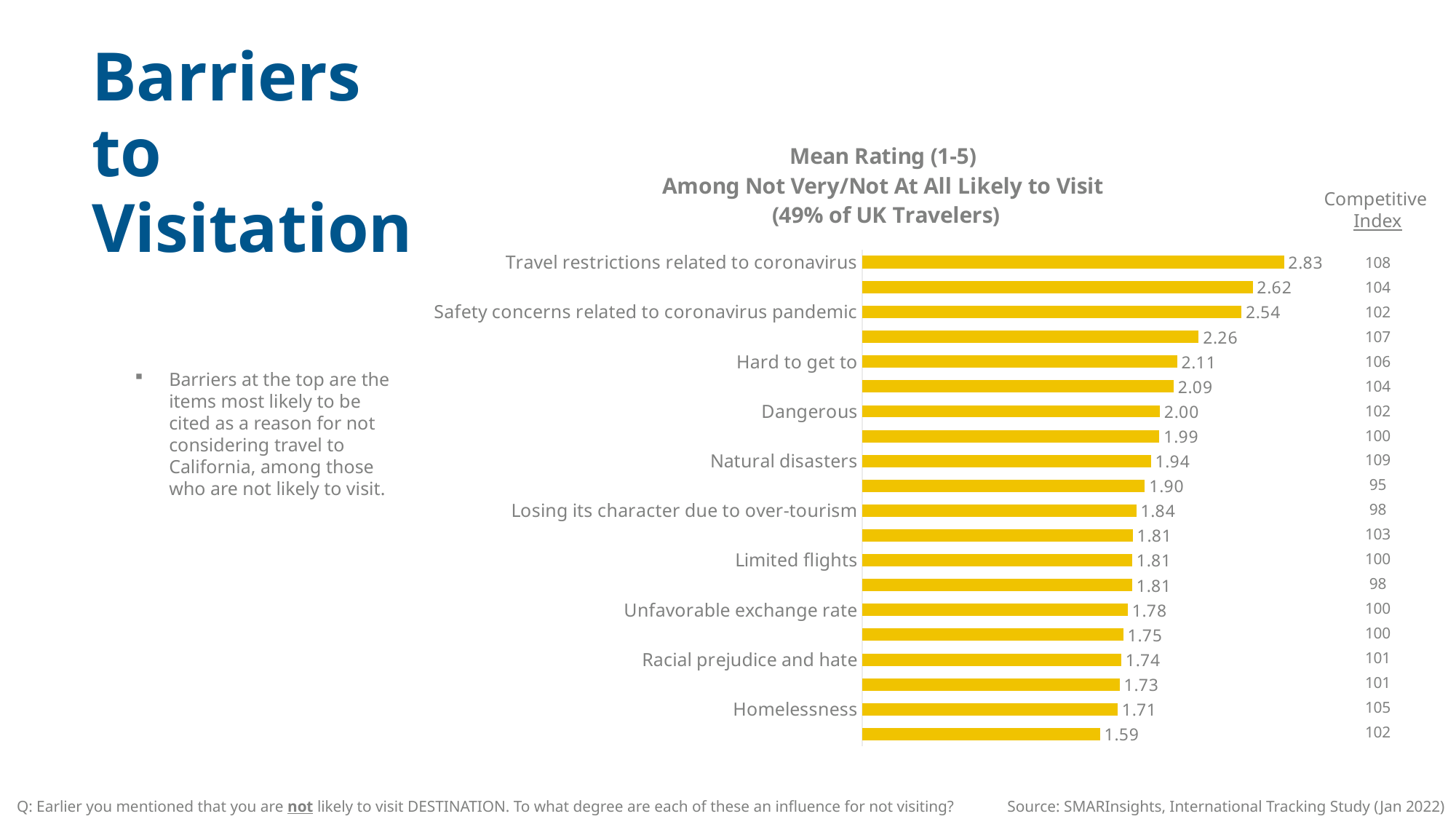
What is the lowest mean rating shown on the chart? 1.59 What is the mean rating for Travel restrictions related to coronavirus? 2.83 Which barrier has the highest mean rating? Travel restrictions related to coronavirus What is the difference between the mean ratings for Travel restrictions related to coronavirus and Safety concerns related to coronavirus pandemic? 0.29 Do the mean ratings increase or decrease going from the top bar to the bottom bar? Decrease What colour are the bars in the chart? Yellow Which has a higher mean rating, Dangerous or Unfavorable exchange rate? Dangerous What is the mean rating for Hard to get to? 2.11 What kind of chart is shown on the slide? Bar chart What is the Competitive Index value for Natural disasters? 109 How many bars are plotted on the chart? 20 What is the mean rating for Homelessness? 1.71